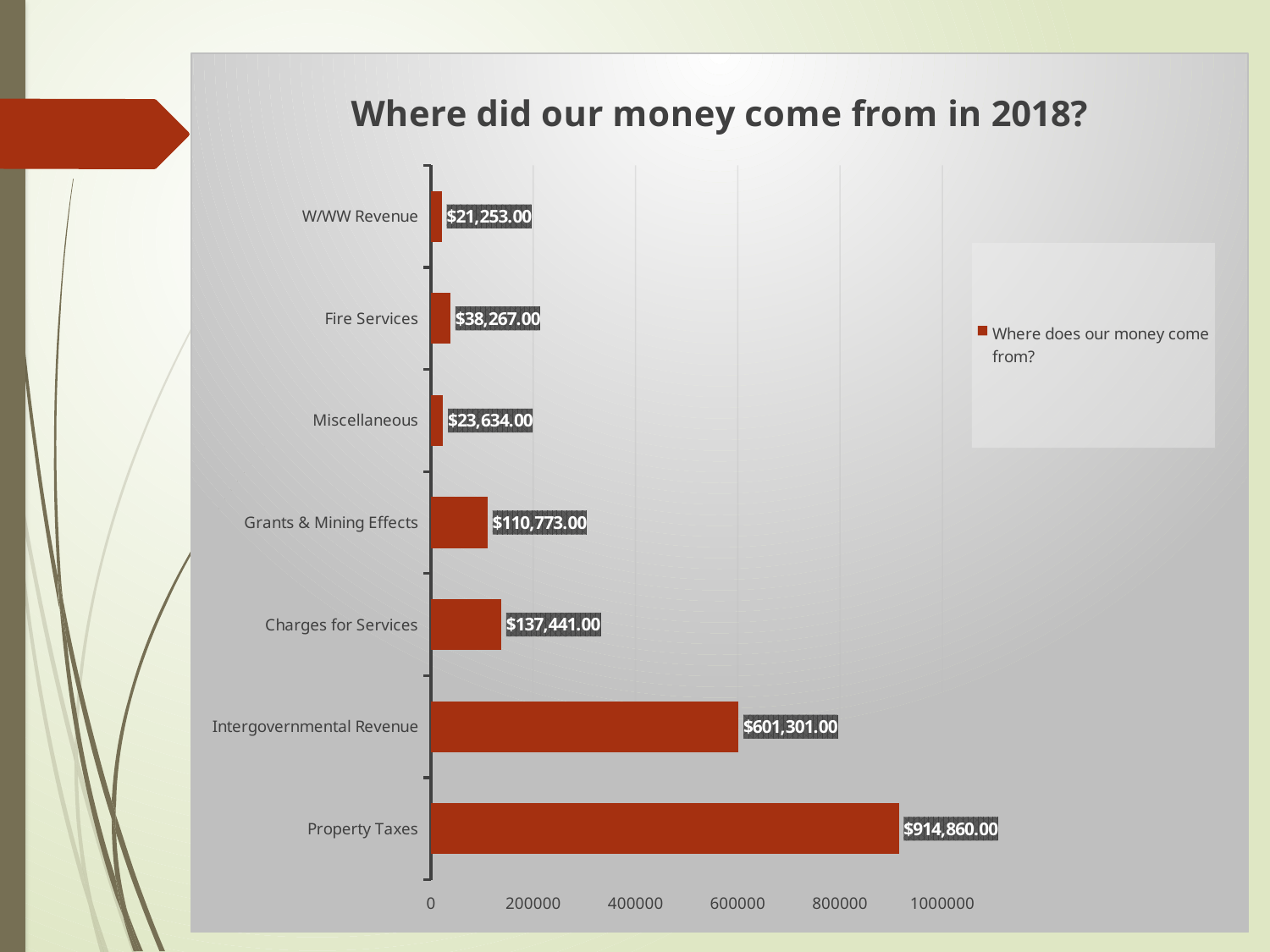
What is the title of the chart? Where did our money come from in 2018? What is the value for Property Taxes? $914,860.00 Which category has the lowest value? W/WW Revenue What is the difference between Property Taxes and Intergovernmental Revenue? $313,559.00 What is the value for Intergovernmental Revenue? $601,301.00 Is the value for Intergovernmental Revenue greater or less than 400000? greater What is the value for Fire Services? $38,267.00 What is the value for Grants & Mining Effects? $110,773.00 What kind of chart is shown on the slide? Bar chart Which category has the highest value? Property Taxes How many categories are shown in the chart? 7 Which is larger, Charges for Services or Grants & Mining Effects? Charges for Services